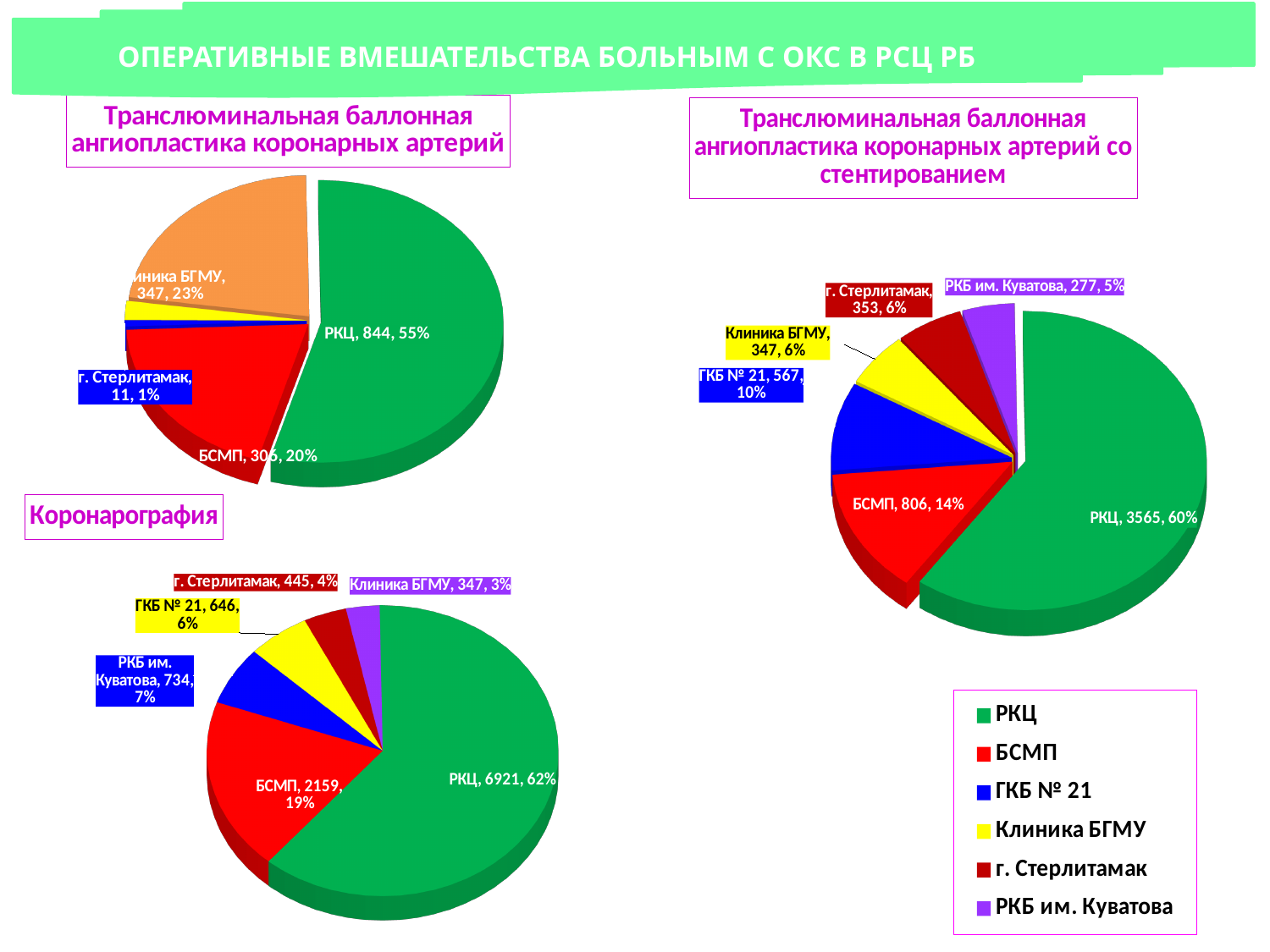
In the chart 'Транслюминальная баллонная ангиопластика коронарных артерий со стентированием', what is the value for ГКБ № 21? 567 What type of chart is used for 'Коронарография'? Pie chart In the chart 'Транслюминальная баллонная ангиопластика коронарных артерий со стентированием', which category has the smallest value? РКБ им. Куватова In the chart 'Транслюминальная баллонная ангиопластика коронарных артерий со стентированием', what is the difference between the values for РКЦ and БСМП? 2759 In the top-left chart 'Транслюминальная баллонная ангиопластика коронарных артерий', what is the value for РКЦ? 844 In the 'Коронарография' chart, which is larger: РКБ им. Куватова or ГКБ № 21? РКБ им. Куватова In the 'Коронарография' chart, which category has the largest slice? РКЦ In the 'Коронарография' chart, what share of the pie does РКЦ account for? 62% In the 'Коронарография' chart, what is the value for БСМП? 2159 In the chart 'Транслюминальная баллонная ангиопластика коронарных артерий со стентированием', what is the value for РКЦ? 3565 In the 'Коронарография' chart, which category has the smallest value? Клиника БГМУ How many entries does the legend on the slide list? 6